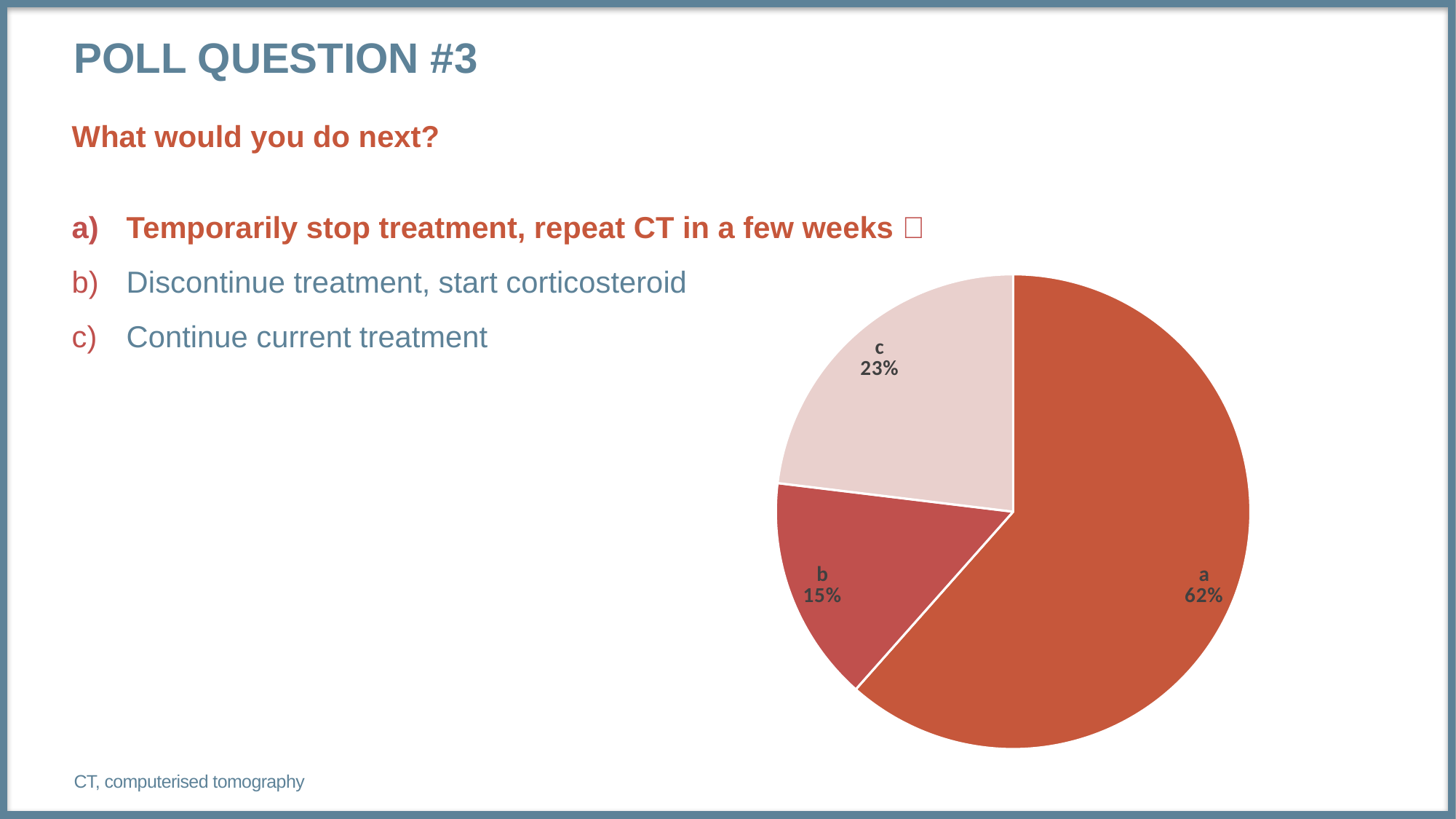
What kind of chart is shown on the slide? pie chart Which slice is larger, b or c? c What is the difference in percentage points between slice a and slice c? 39 Which slice of the pie chart is the smallest? b What percentage of the pie does slice b represent? 15% What percentage of the pie does slice a represent? 62% What is the difference in percentage points between slice c and slice b? 8 What percentage of the pie does slice c represent? 23% How many slices does the pie chart have? 3 Which slice of the pie chart is the largest? a What is the combined share of slices b and c? 38% Which slice of the pie chart is the lightest in colour? c